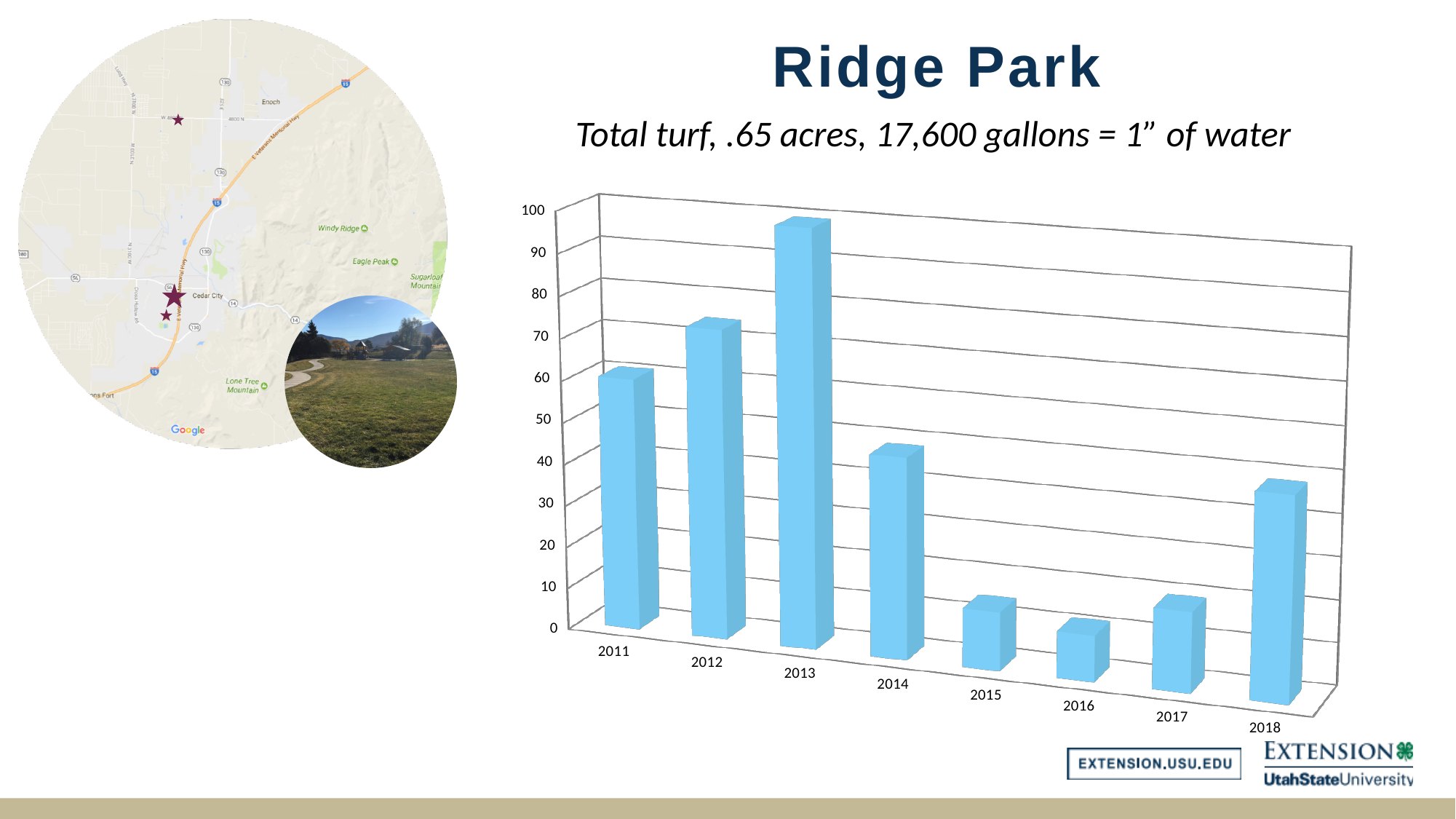
What is the title of the slide containing the chart? Ridge Park Which year has the larger value, 2011 or 2012? 2012 Do the values rise or fall from 2013 to 2016? fall What kind of chart is shown on the slide? bar chart Which year has the lowest bar in the chart? 2016 Is the value for 2018 greater or less than 20? greater Is the value for 2011 greater or less than 50? greater Which year has the highest bar in the chart? 2013 How many years are shown on the x axis of the chart? 8 Is the value for 2013 greater or less than 80? greater